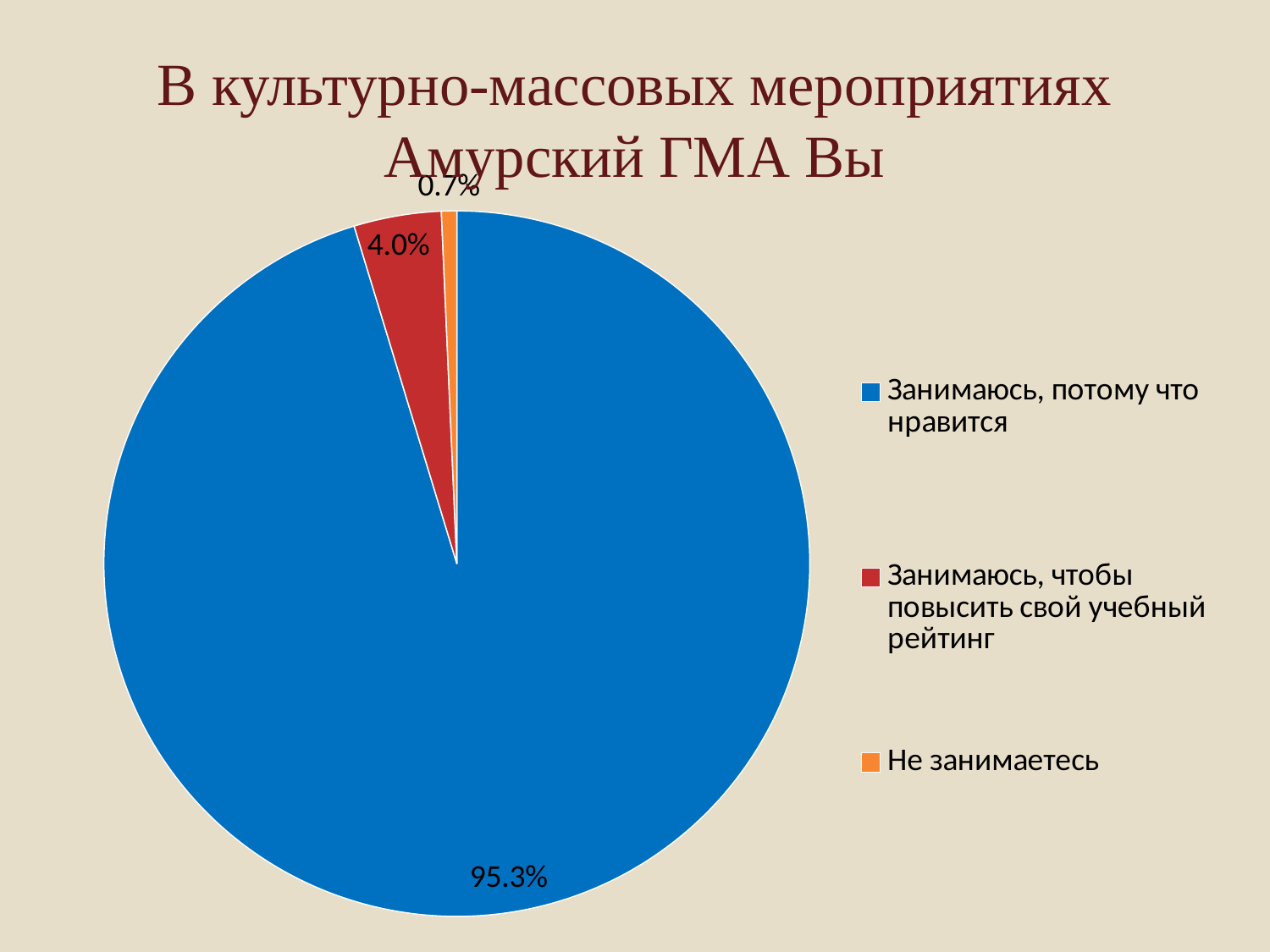
What share of the pie is labelled "Занимаюсь, чтобы повысить свой учебный рейтинг"? 4.0% What is the difference between the shares for "Занимаюсь, чтобы повысить свой учебный рейтинг" and "Не занимаетесь"? 3.3% What is the title of the slide? В культурно-массовых мероприятиях Амурский ГМА Вы Which is larger: the share for "Занимаюсь, чтобы повысить свой учебный рейтинг" or the share for "Не занимаетесь"? Занимаюсь, чтобы повысить свой учебный рейтинг What share of the pie is labelled "Не занимаетесь"? 0.7% Which category has the smallest slice of the pie? Не занимаетесь What colour is the slice for "Не занимаетесь"? orange What share of the pie is labelled "Занимаюсь, потому что нравится"? 95.3% How many entries does the legend list? 3 Which category has the largest slice of the pie? Занимаюсь, потому что нравится What type of chart is shown on the slide? pie chart How many categories does the pie chart have? 3